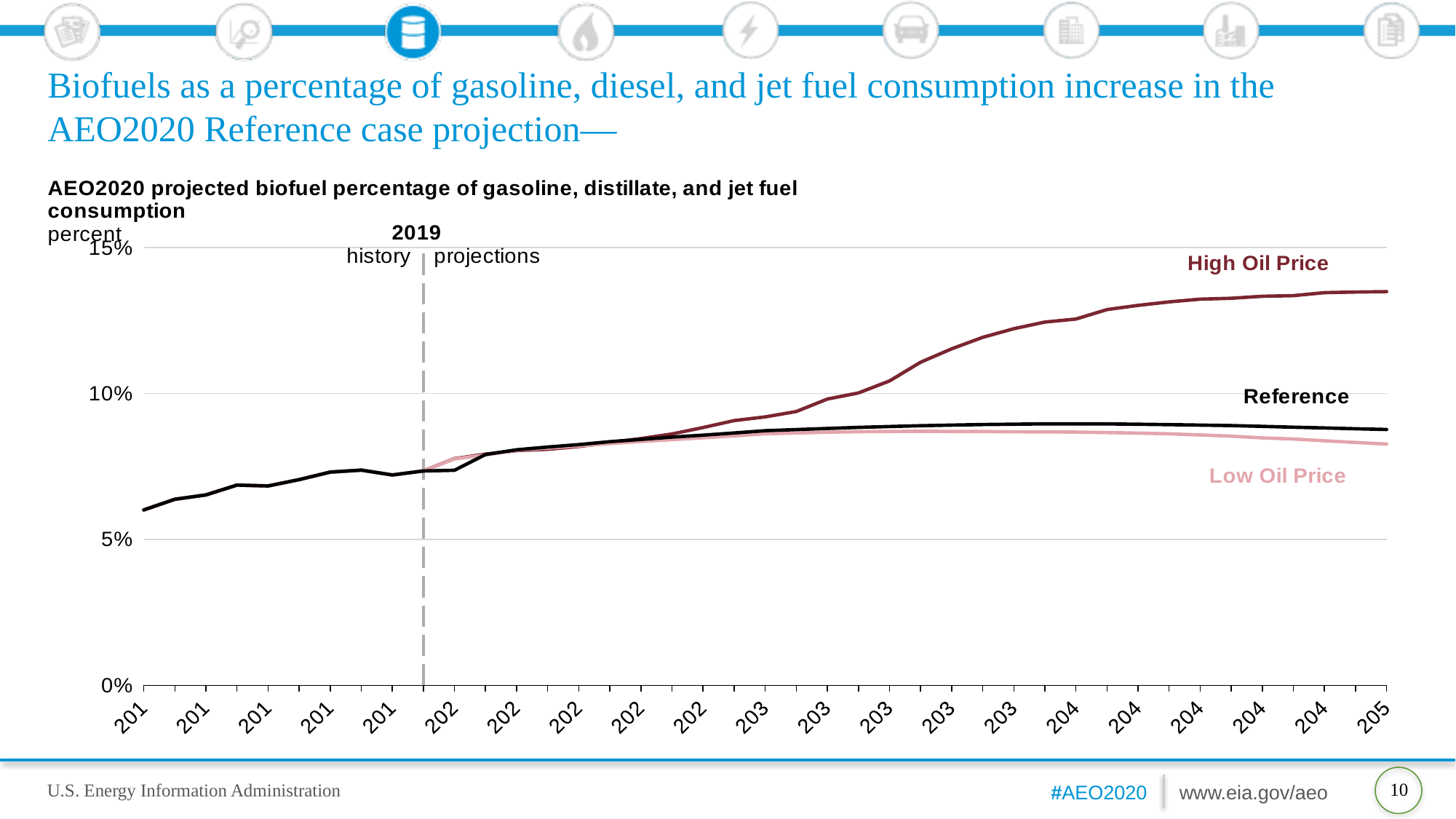
How many series are plotted on the chart? 3 Is the value of the Reference series at the right end of the chart greater or less than 10%? less Does the High Oil Price series rise or fall over the projection period? rise Is the value of the High Oil Price series at the right end of the chart greater or less than 10%? greater Does the Low Oil Price series rise or fall over the last part of the projection period? fall At the right end of the chart, which is larger: the Reference series or the Low Oil Price series? Reference Is the value of the Low Oil Price series at the right end of the chart greater or less than 5%? greater Which series has the highest value at the right end of the chart? High Oil Price What kind of chart is shown on the slide? line chart What unit is the y axis of the chart measured in? percent What year does the dashed vertical line separating history from projections mark? 2019 Which series has the lowest value at the right end of the chart? Low Oil Price